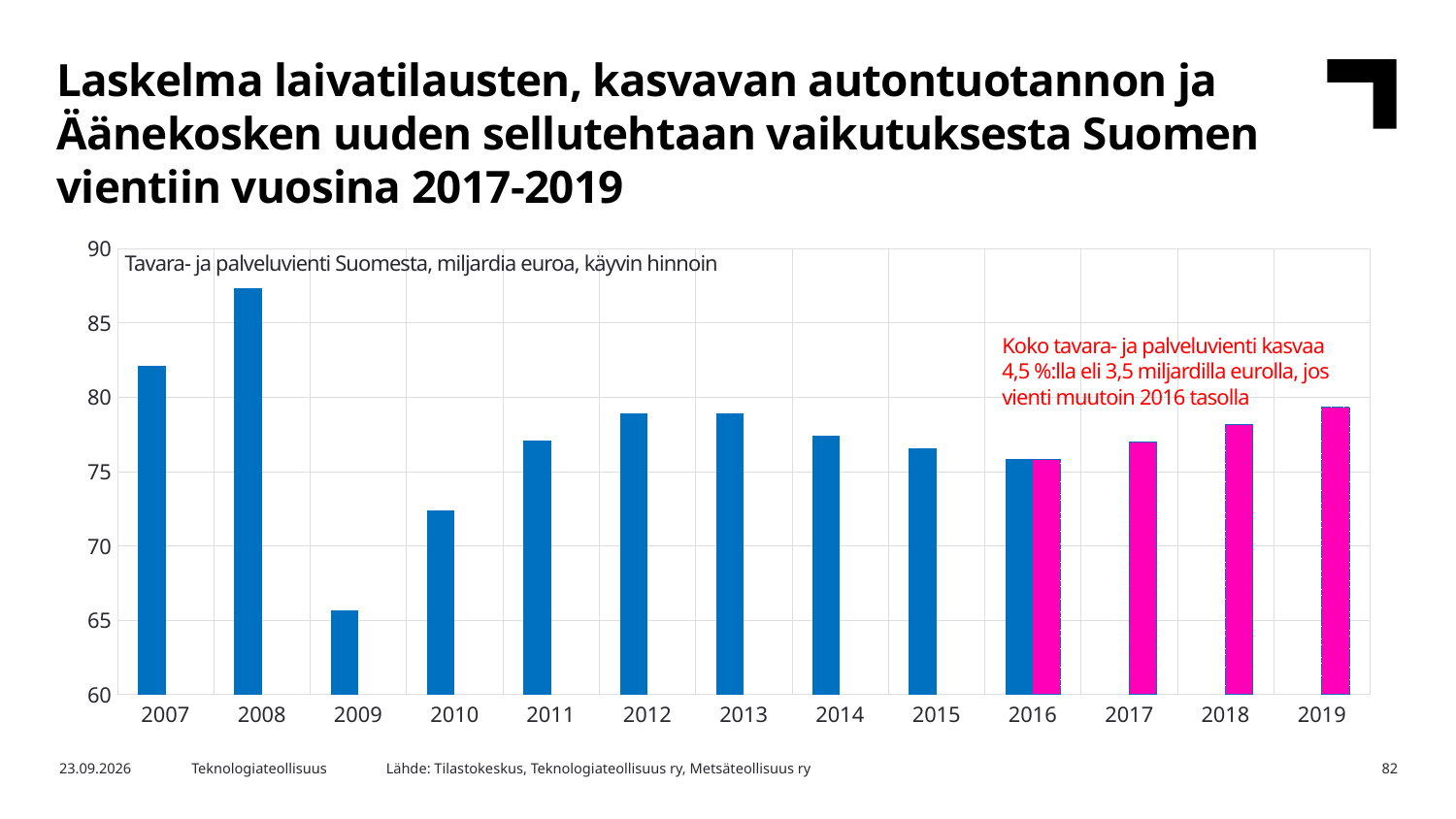
What is the subtitle text shown inside the chart area? Tavara- ja palveluvienti Suomesta, miljardia euroa, käyvin hinnoin Is the value for 2008 greater or less than 85? greater Which year has the larger value, 2007 or 2010? 2007 Is the value for 2009 greater or less than 70? less Is the value for 2010 greater or less than 75? less Which year has the highest export value in the chart? 2008 How many years are shown on the x axis of the chart? 13 What kind of chart is shown on the slide? Bar chart Which year has the larger value, 2016 or 2019? 2019 Which year has the lowest export value in the chart? 2009 Do the values rise or fall from 2016 to 2019? rise